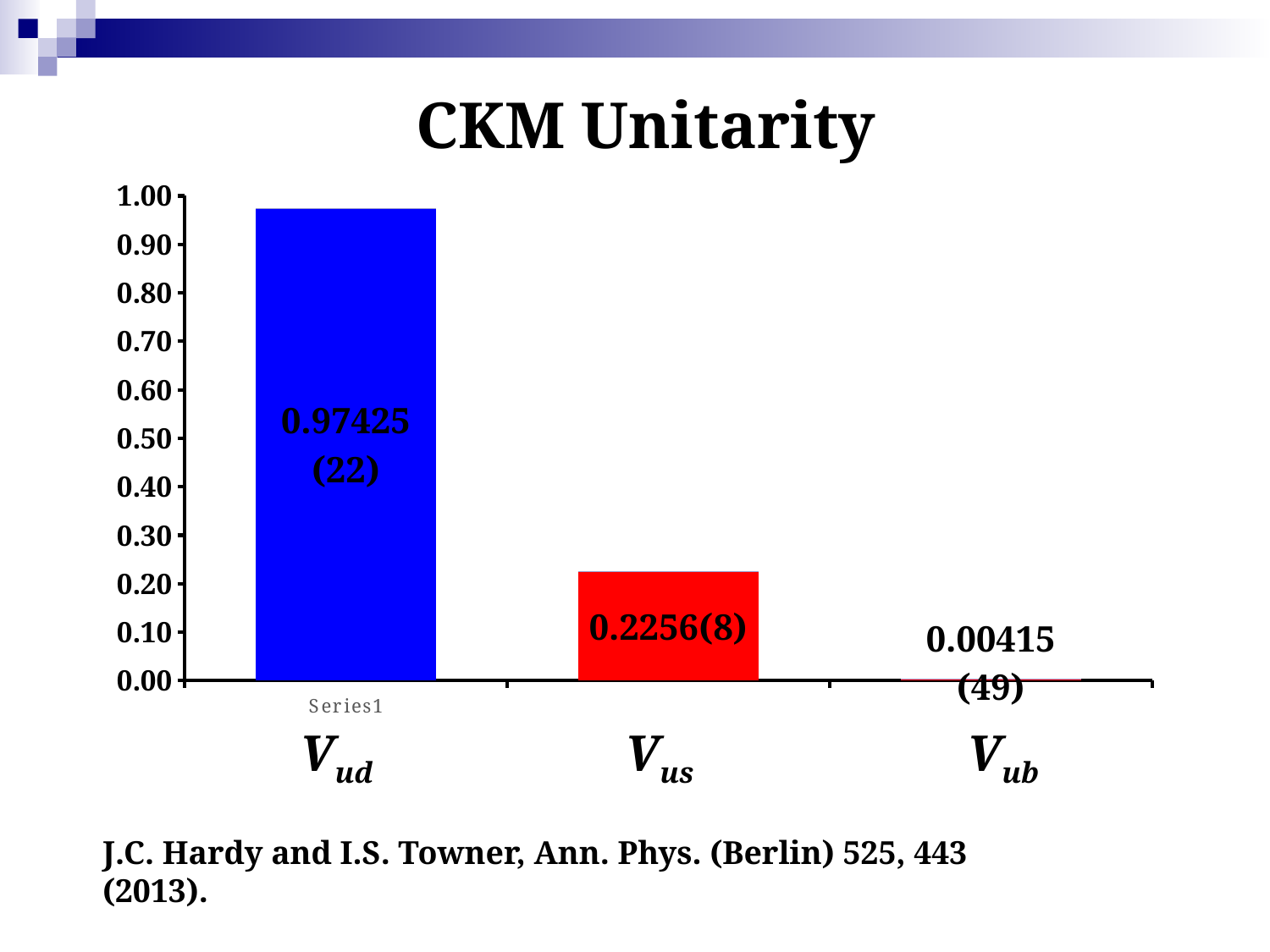
Which is larger, the value for V_us or the value for V_ub? V_us What is the title of the chart? CKM Unitarity What colour is the bar for V_us? red What value is labelled on the bar for V_us? 0.2256(8) Is the value for V_us greater or less than 0.30? less Which category has the highest bar? V_ud What value is labelled for V_ub? 0.00415(49) Is the value for V_ud greater or less than 0.90? greater How many categories are shown on the x axis? 3 Which category has the lowest value? V_ub What kind of chart is shown on the slide? bar chart What value is labelled on the bar for V_ud? 0.97425(22)